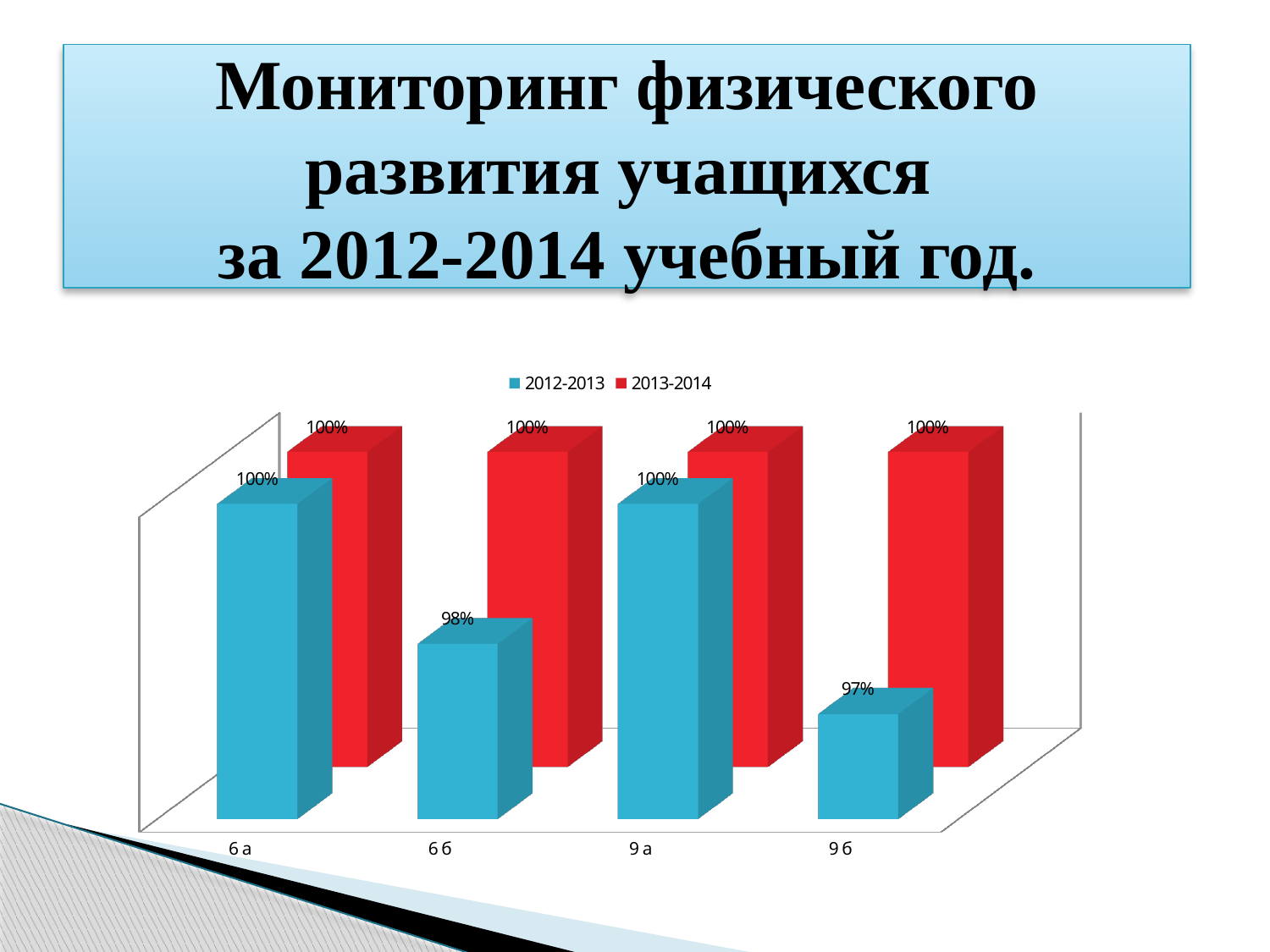
How many categories are shown on the x axis? 4 Which series is shown in red? 2013-2014 What is the value for 9 б in the 2013-2014 series? 100% What type of chart is shown on the slide? bar chart Which is larger for 6 б: the 2012-2013 value or the 2013-2014 value? 2013-2014 What is the value for 6 б in the 2012-2013 series? 98% Which category has the lowest value in the 2012-2013 series? 9 б What is the value for 9 б in the 2012-2013 series? 97% What is the difference between the 2013-2014 and 2012-2013 values for 9 б? 3% How many series does the legend list? 2 What is the difference between the 2012-2013 values for 6 б and 9 б? 1% What is the value for 6 а in the 2012-2013 series? 100%